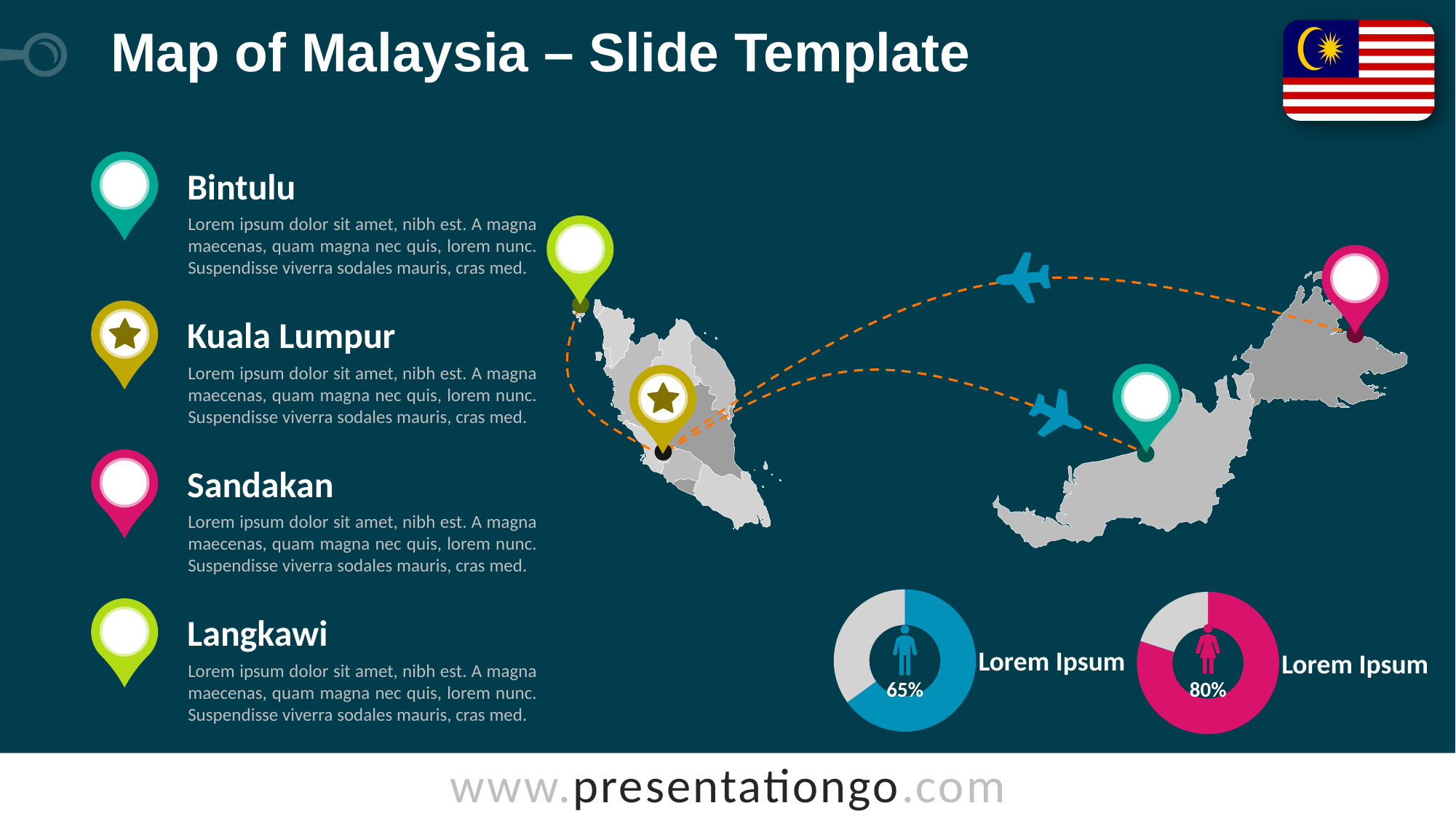
What percentage is shown in the left donut chart at the bottom of the slide? 65% What kind of chart is used at the bottom of the slide to show the 65% and 80% values? donut chart How many donut charts are shown on the slide? 2 What is the difference between the percentage in the right donut chart and the percentage in the left donut chart? 15 percentage points What label text appears to the right of each donut chart? Lorem Ipsum Which of the two donut charts at the bottom of the slide shows the larger percentage, the left one or the right one? the right one In the left donut chart, what share of the ring is not filled by the 65% segment? 35% What percentage is shown in the right donut chart at the bottom of the slide? 80% In the right donut chart, what share of the ring is not filled by the 80% segment? 20% What colour is the filled segment of the left donut chart? blue